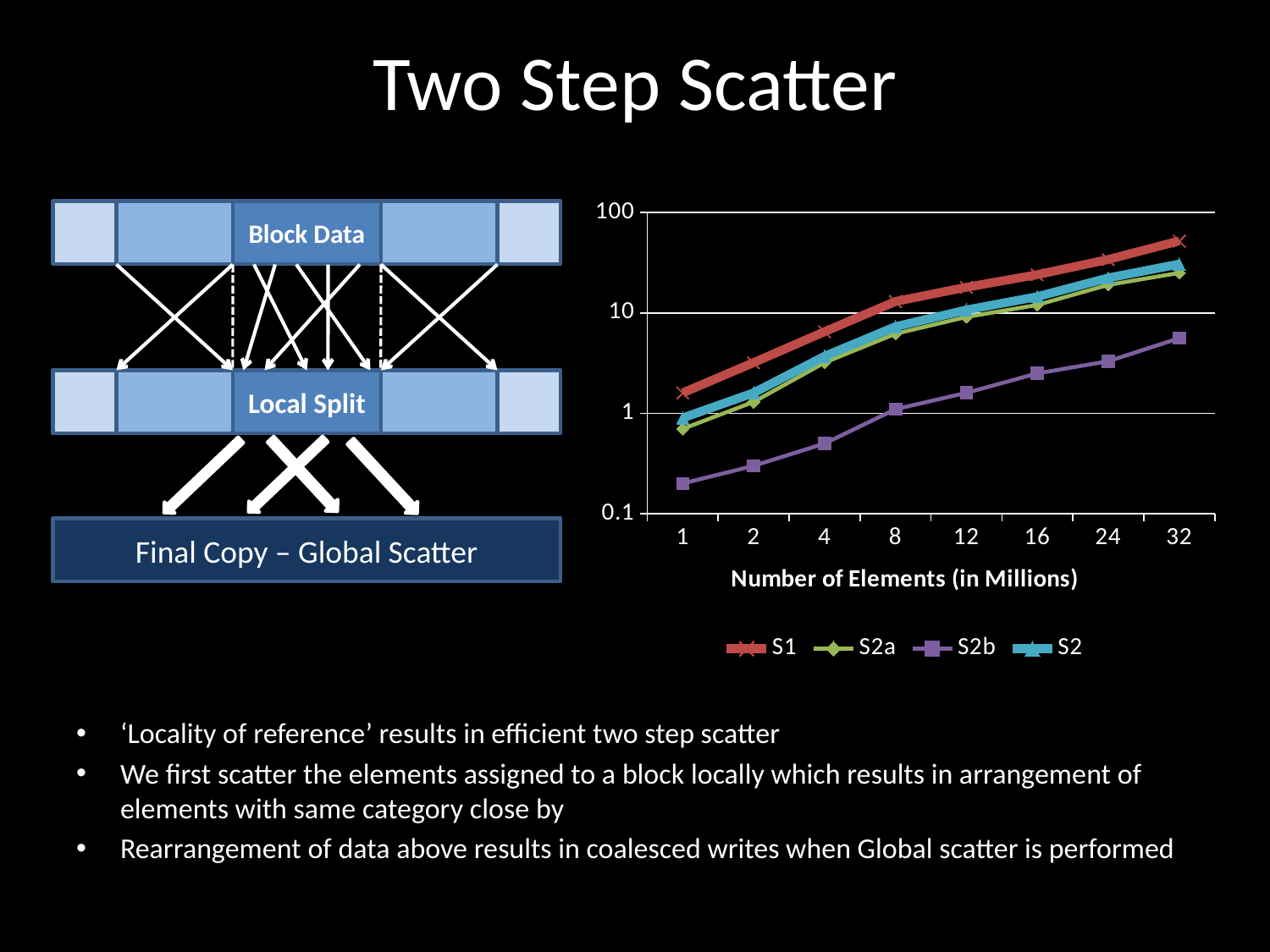
How many x-axis categories (numbers of elements) are plotted on the chart? 8 What is the x-axis title of the chart? Number of Elements (in Millions) Which series are listed in the chart's legend? S1, S2a, S2b, S2 How many series does the legend of the chart list? 4 Is the value for S1 at 32 million elements greater or less than 10? greater Do the values of S1 rise or fall as the number of elements increases? rise Is the value for S2b at 1 million elements greater or less than 1? less Which series has the highest value at 32 million elements? S1 Which series has the lowest value at 32 million elements? S2b Is the value for S2b at 32 million elements greater or less than 10? less What kind of chart is shown on the slide? line chart Which is larger at 4 million elements, S2a or S2b? S2a